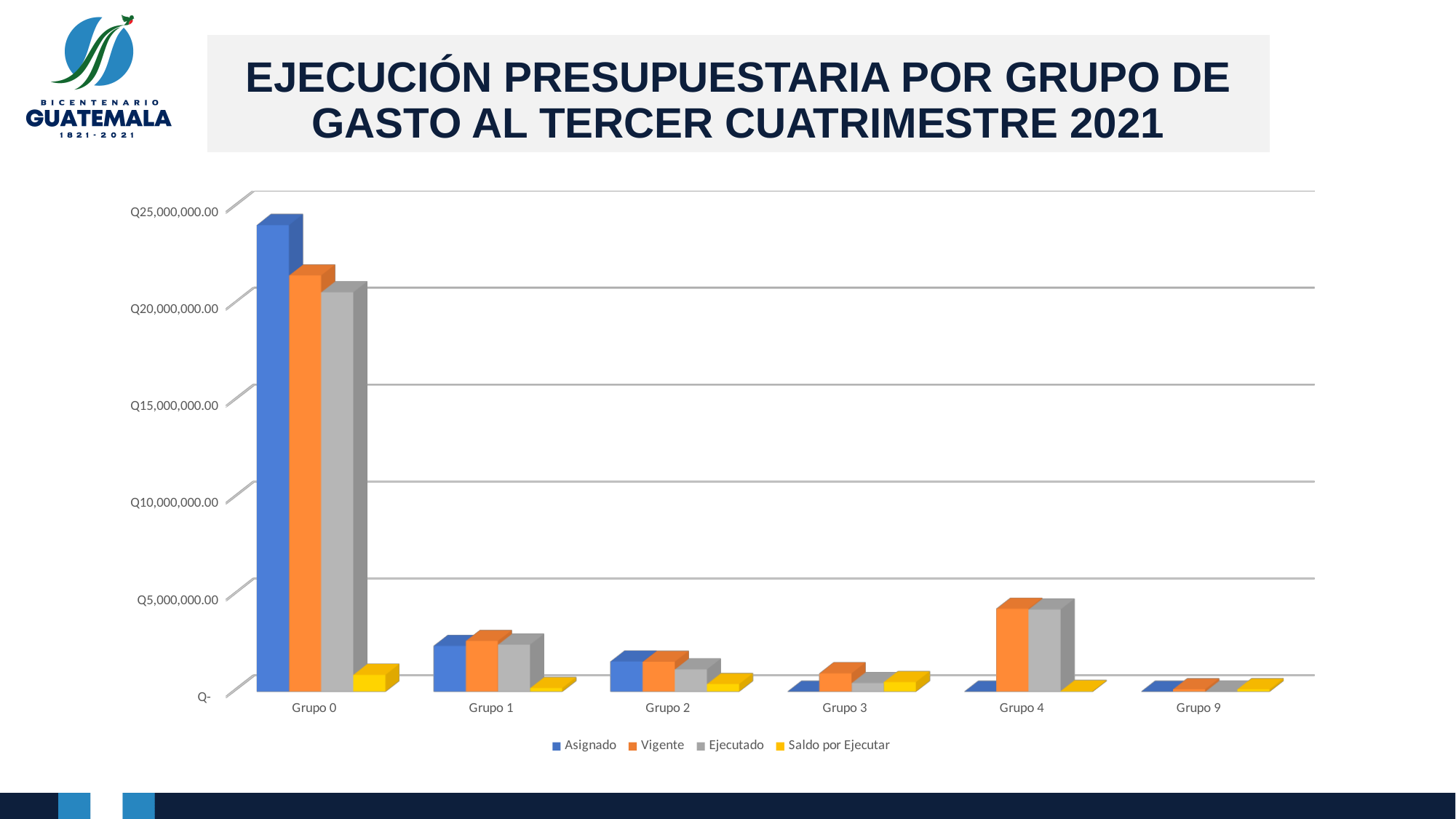
Which category has the highest Asignado value? Grupo 0 What kind of chart is shown on the slide? bar chart Which is larger for Grupo 0: the Asignado value or the Vigente value? Asignado How many categories (grupos) are shown on the x axis? 6 Is the Asignado value for Grupo 1 greater or less than Q5,000,000.00? less Which category has the larger Asignado value: Grupo 0 or Grupo 4? Grupo 0 Which category has the larger Vigente value: Grupo 1 or Grupo 4? Grupo 4 Is the Asignado value for Grupo 0 greater or less than Q20,000,000.00? greater How many series does the legend list? 4 Which series is shown in yellow in the legend? Saldo por Ejecutar What is the title of the chart on the slide? EJECUCIÓN PRESUPUESTARIA POR GRUPO DE GASTO AL TERCER CUATRIMESTRE 2021 Is the Vigente value for Grupo 4 greater or less than Q5,000,000.00? less